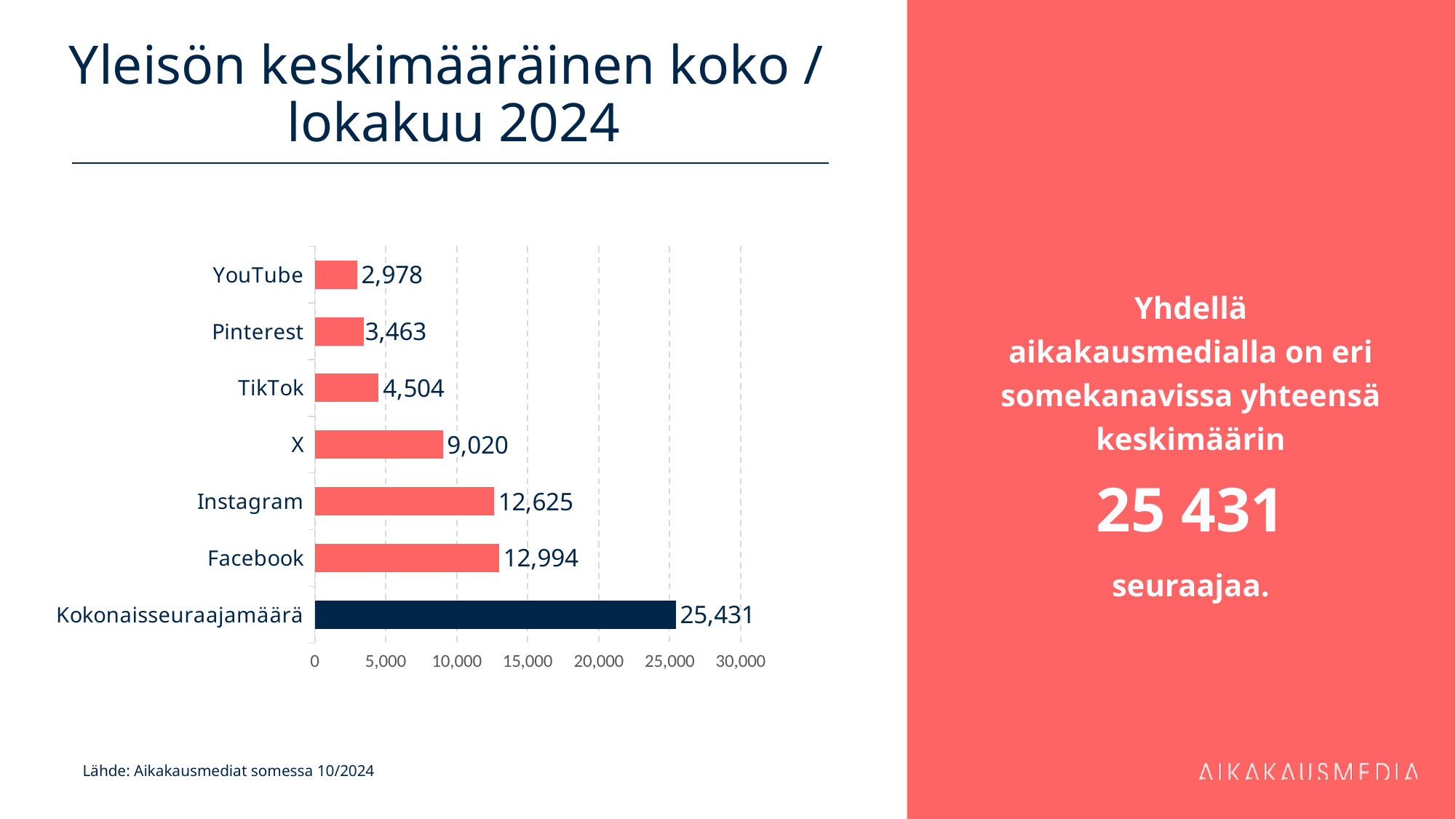
What is the value for Facebook? 12,994 Which category has the highest value? Kokonaisseuraajamäärä Which category has the lowest value? YouTube Is the value for Instagram greater or less than 10,000? greater What is the difference between the values for Facebook and Instagram? 369 What is the value for TikTok? 4,504 What is the title of the slide containing the chart? Yleisön keskimääräinen koko / lokakuu 2024 Which is larger, the value for Pinterest or the value for YouTube? Pinterest What is the difference between the values for X and TikTok? 4,516 What kind of chart is shown on the slide? bar chart What is the value for X? 9,020 How many categories are shown in the chart? 7